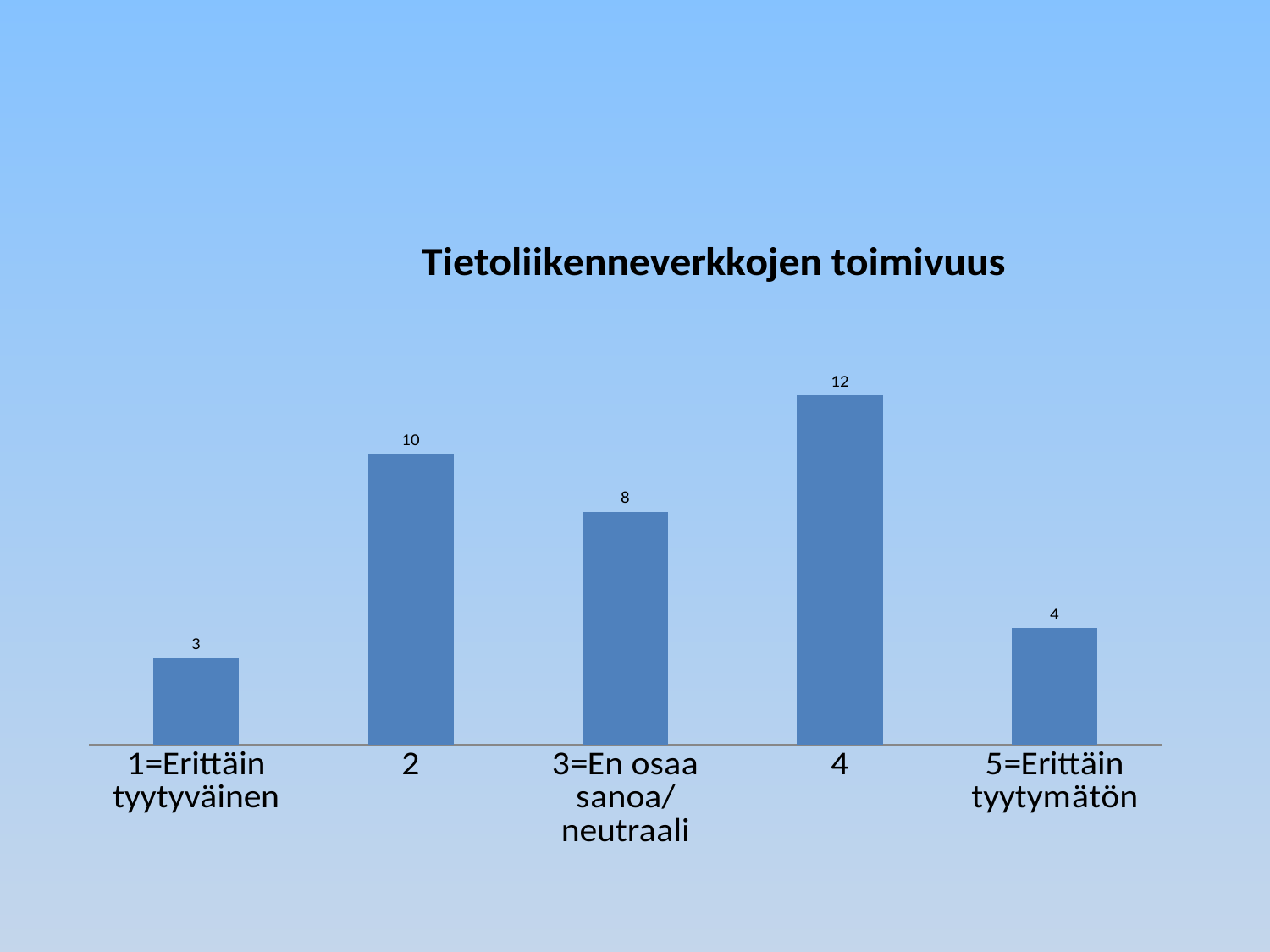
What is the value for "3=En osaa sanoa/neutraali"? 8 What is the value for "5=Erittäin tyytymätön"? 4 What is the difference between the values for "5=Erittäin tyytymätön" and "1=Erittäin tyytyväinen"? 1 How many categories are shown on the x axis? 5 What is the value for "1=Erittäin tyytyväinen"? 3 Which category has the highest value? 4 What is the title of the chart? Tietoliikenneverkkojen toimivuus What is the difference between the values for "4" and "2"? 2 What kind of chart is shown on the slide? Bar chart Which is larger, the value for "2" or the value for "3=En osaa sanoa/neutraali"? 2 What is the value for the category "4"? 12 Which category has the lowest value? 1=Erittäin tyytyväinen